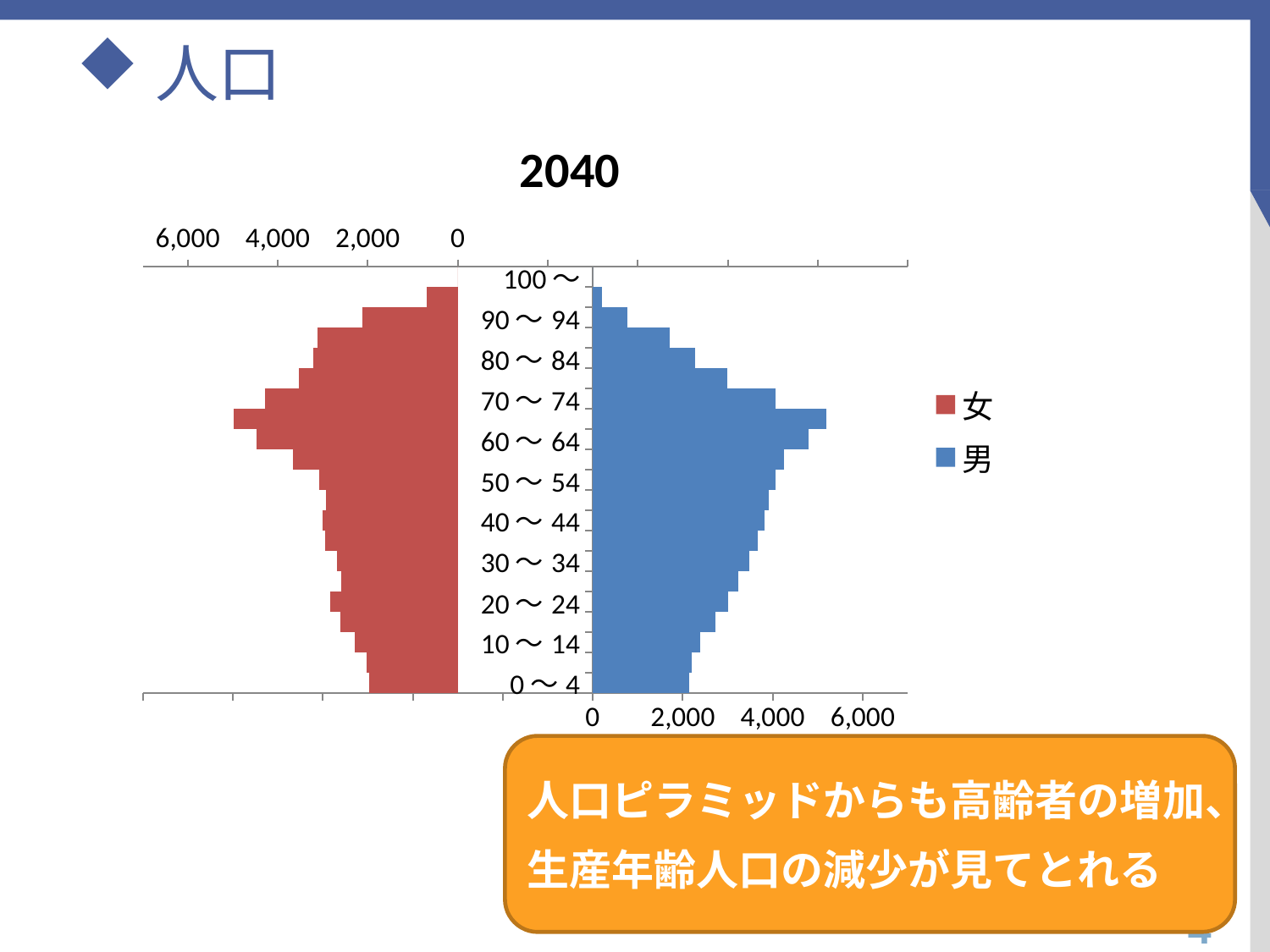
Is the value for 男 in the 100～ age group greater or less than 2,000? less What kind of chart is shown on the slide? bar chart Is the value for 男 in the 20～24 age group greater or less than 2,000? greater Which series is shown in blue? 男 Is the value for 男 in the 20～24 age group greater or less than 4,000? less How many series does the legend list? 2 What is the title of the chart? 2040 Which is larger for 男: the value for the 60～64 age group or the 0～4 age group? 60～64